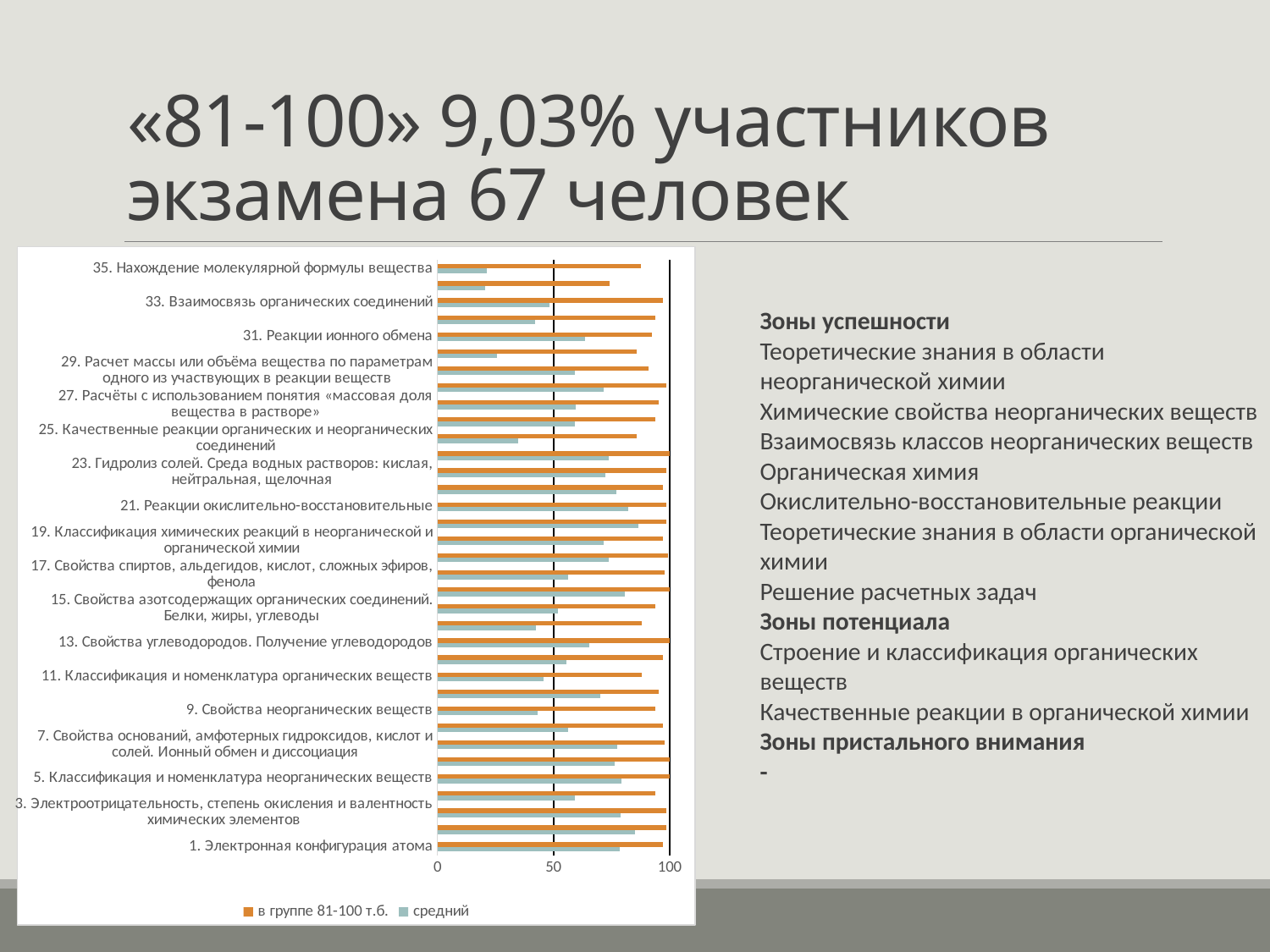
Is the 'в группе 81-100 т.б.' value for '35. Нахождение молекулярной формулы вещества' greater or less than 50? greater What kind of chart is shown on the slide? bar chart Is the 'средний' value for '35. Нахождение молекулярной формулы вещества' greater or less than 50? less Is the 'в группе 81-100 т.б.' value for '13. Свойства углеводородов. Получение углеводородов' greater or less than 50? greater Which series is shown in orange in the chart? в группе 81-100 т.б. What are the two series named in the chart legend? в группе 81-100 т.б. and средний How many series does the chart legend list? 2 For '1. Электронная конфигурация атома', which series has the larger value: 'в группе 81-100 т.б.' or 'средний'? в группе 81-100 т.б. What is the maximum value shown on the chart's horizontal axis? 100 For '35. Нахождение молекулярной формулы вещества', which series has the larger value: 'в группе 81-100 т.б.' or 'средний'? в группе 81-100 т.б.